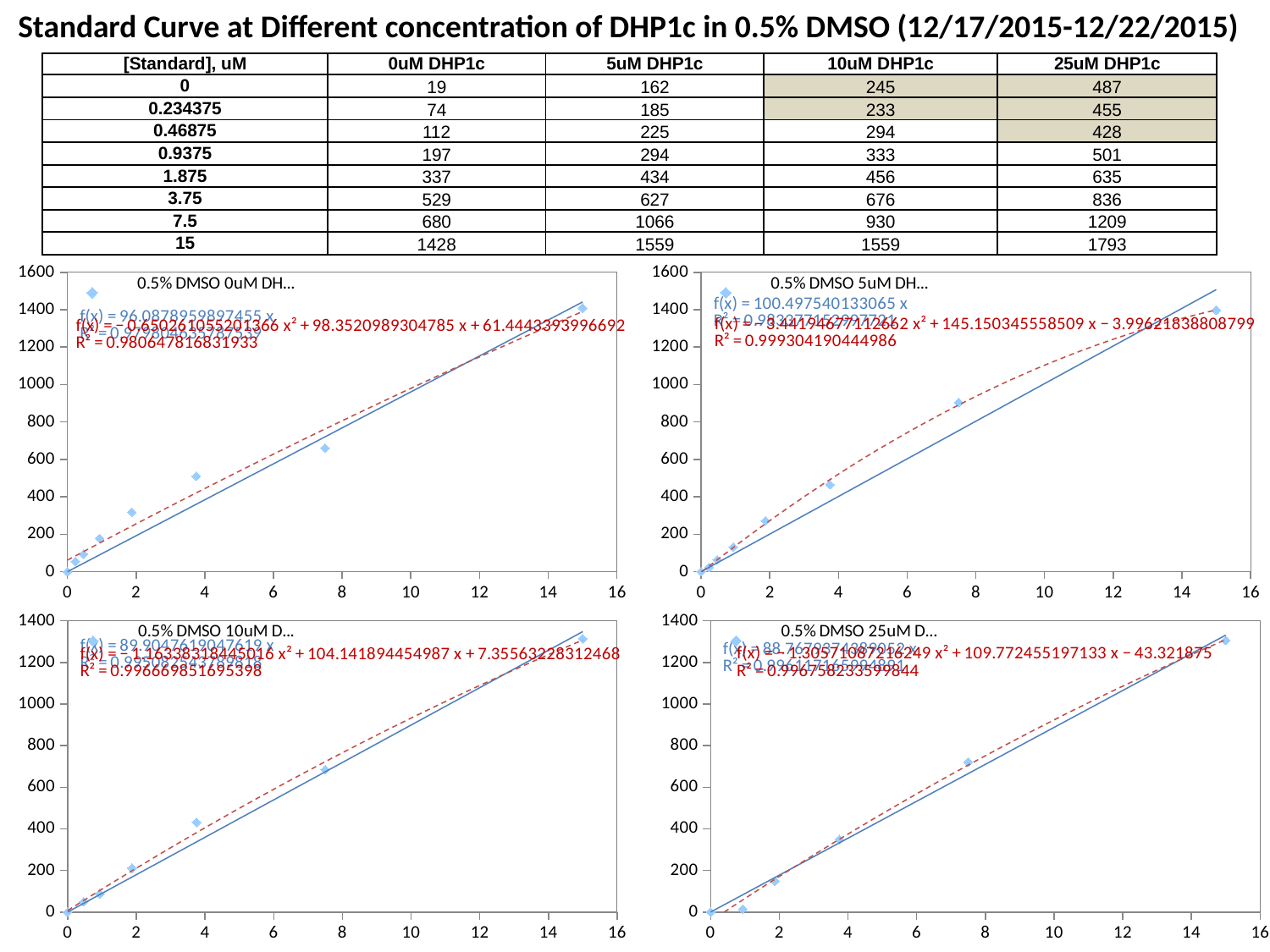
In the top-right chart (0.5% DMSO 5uM), is the plotted value at x = 15 greater or less than 1200? greater In the top-right chart (0.5% DMSO 5uM), what R² value is printed in red for the polynomial fit? 0.999304190444986 What is the highest tick value on the y axis of the bottom-left chart (0.5% DMSO 10uM)? 1400 What kind of chart is the top-left chart titled '0.5% DMSO 0uM DH...'? scatter chart In the bottom-right chart (0.5% DMSO 25uM), do the plotted values rise or fall as x increases? rise In the top-right chart (0.5% DMSO 5uM), is the plotted value at x = 3.75 greater or less than 600? less In the bottom-left chart (0.5% DMSO 10uM), is the plotted value at x = 3.75 greater or less than 600? less In the top-left chart (0.5% DMSO 0uM), which has the larger plotted value, x = 7.5 or x = 15? x = 15 What is the highest tick value on the y axis of the top-right chart (0.5% DMSO 5uM)? 1600